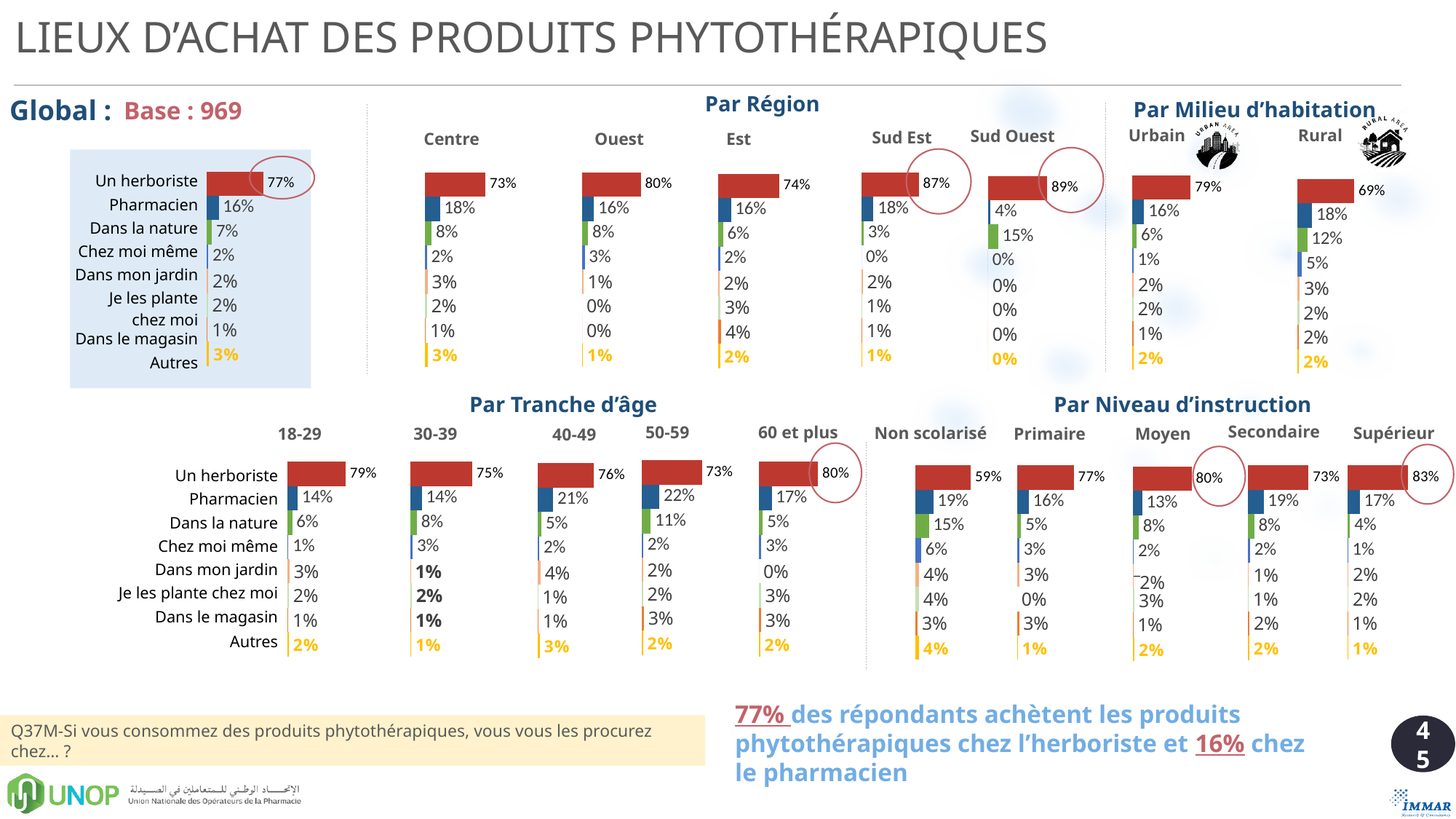
In the Par Niveau d'instruction charts, which education level has the lowest 'Un herboriste' value? Non scolarisé In the Par Région charts, which region has the highest value for 'Un herboriste'? Sud Ouest In the Par Milieu d'habitation charts, what is the difference between the 'Un herboriste' values for Urbain and Rural? 10% How many purchase-location categories are listed in the Global chart? 8 In the Par Tranche d'âge charts, what is the 'Un herboriste' value for 60 et plus? 80% In the Global chart, what percentage of respondents buy phytotherapy products from 'Un herboriste'? 77% In the Par Région charts, what is the 'Un herboriste' value for Sud Est? 87% In the Par Milieu d'habitation charts, what is the 'Dans la nature' value for Rural? 12% In the Par Tranche d'âge charts, which age group has the highest 'Pharmacien' value? 50-59 What type of chart is used in the Global section? bar chart In the Global chart, what is the value for 'Pharmacien'? 16% In the Par Niveau d'instruction charts, is the 'Un herboriste' value for Supérieur larger or smaller than that for Secondaire? larger